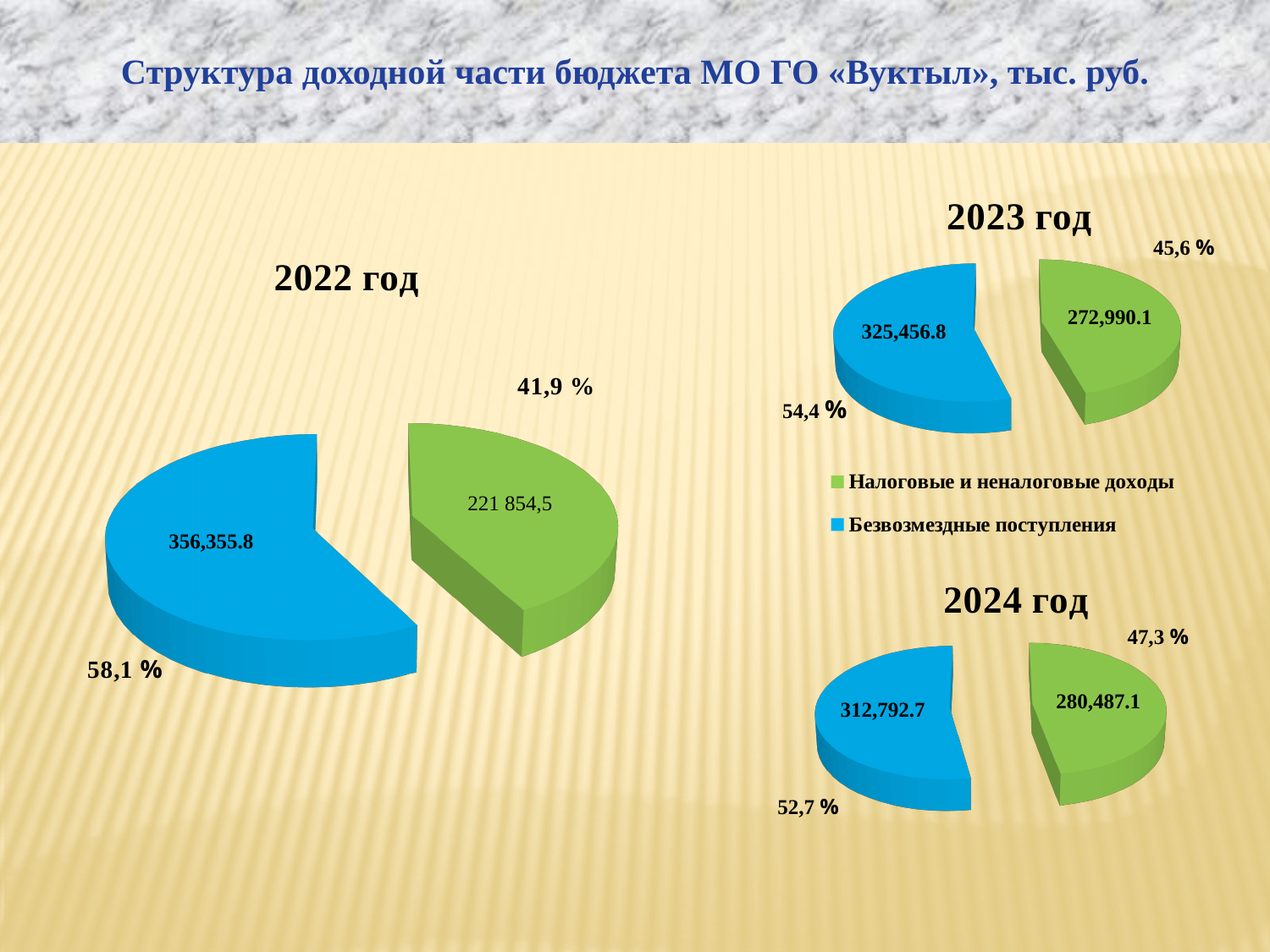
In the 2024 год chart, what share of the pie is Безвозмездные поступления? 52,7 % In the 2022 год chart, what is the value for Безвозмездные поступления? 356,355.8 In the 2023 год chart, what share of the pie is Налоговые и неналоговые доходы? 45,6 % In the 2024 год chart, what is the value for Безвозмездные поступления? 312,792.7 In the 2023 год chart, what is the value for Налоговые и неналоговые доходы? 272,990.1 In the 2022 год chart, what share of the pie is Безвозмездные поступления? 58,1 % In the 2023 год chart, which category has the largest slice? Безвозмездные поступления Which colour represents Налоговые и неналоговые доходы in the legend? Green How many categories does the legend list? 2 In the 2024 год chart, which category is larger: Налоговые и неналоговые доходы or Безвозмездные поступления? Безвозмездные поступления What kind of charts are shown on the slide? Pie charts In the 2022 год chart, what is the value for Налоговые и неналоговые доходы? 221 854,5